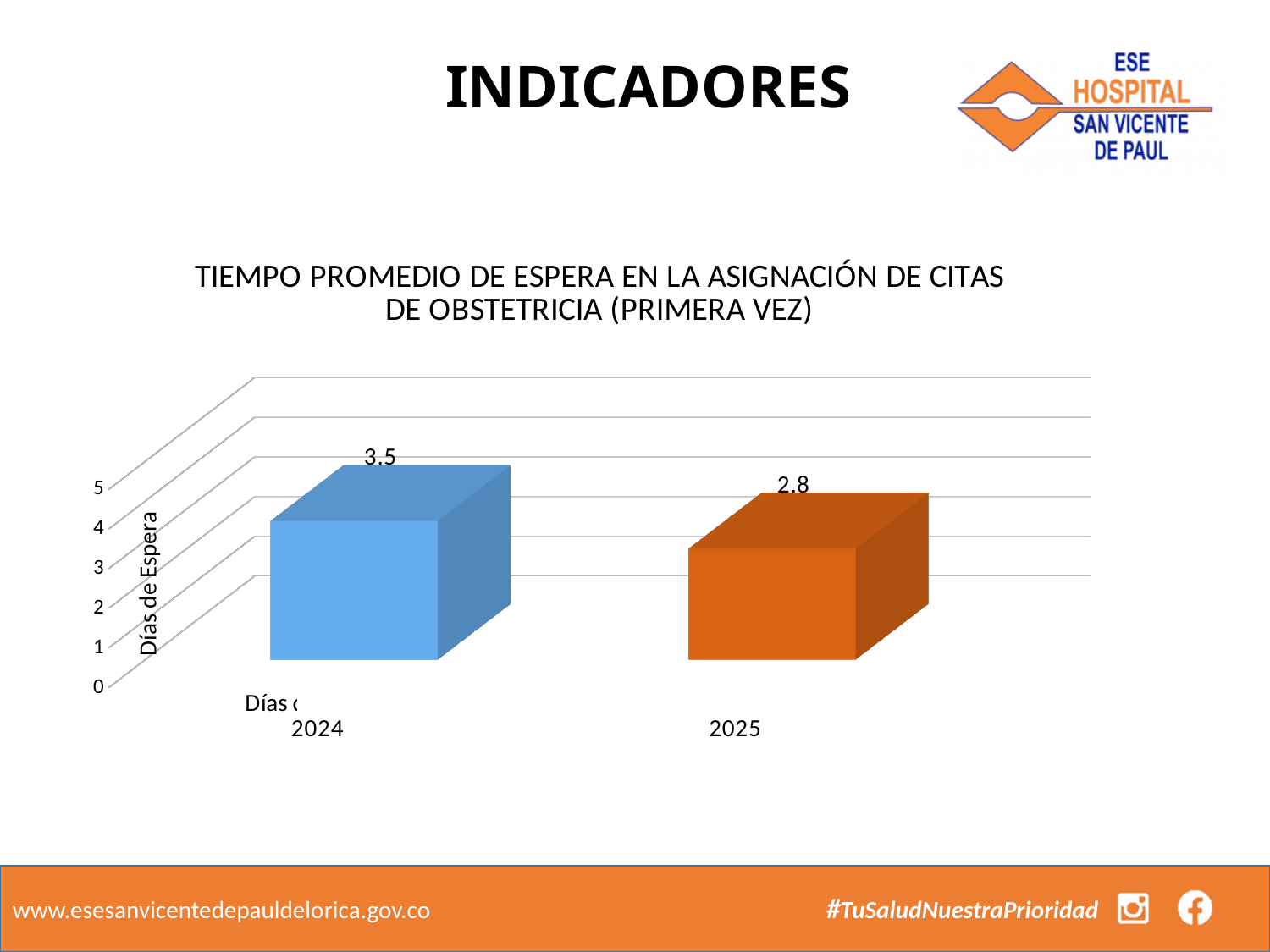
What is the average waiting time in days for 2025? 2.8 Does the average waiting time rise or fall from 2024 to 2025? fall What is the label of the vertical axis? Días de Espera What is the title of the chart? TIEMPO PROMEDIO DE ESPERA EN LA ASIGNACIÓN DE CITAS DE OBSTETRICIA (PRIMERA VEZ) Is the value for 2025 greater or less than 3? less By how many days did the average waiting time decrease from 2024 to 2025? 0.7 What is the average waiting time in days for 2024? 3.5 Is the value for 2024 larger or smaller than the value for 2025? larger How many years are shown on the chart? 2 Which year has the higher average waiting time? 2024 What kind of chart is shown on the slide? bar chart Which year has the lower average waiting time? 2025